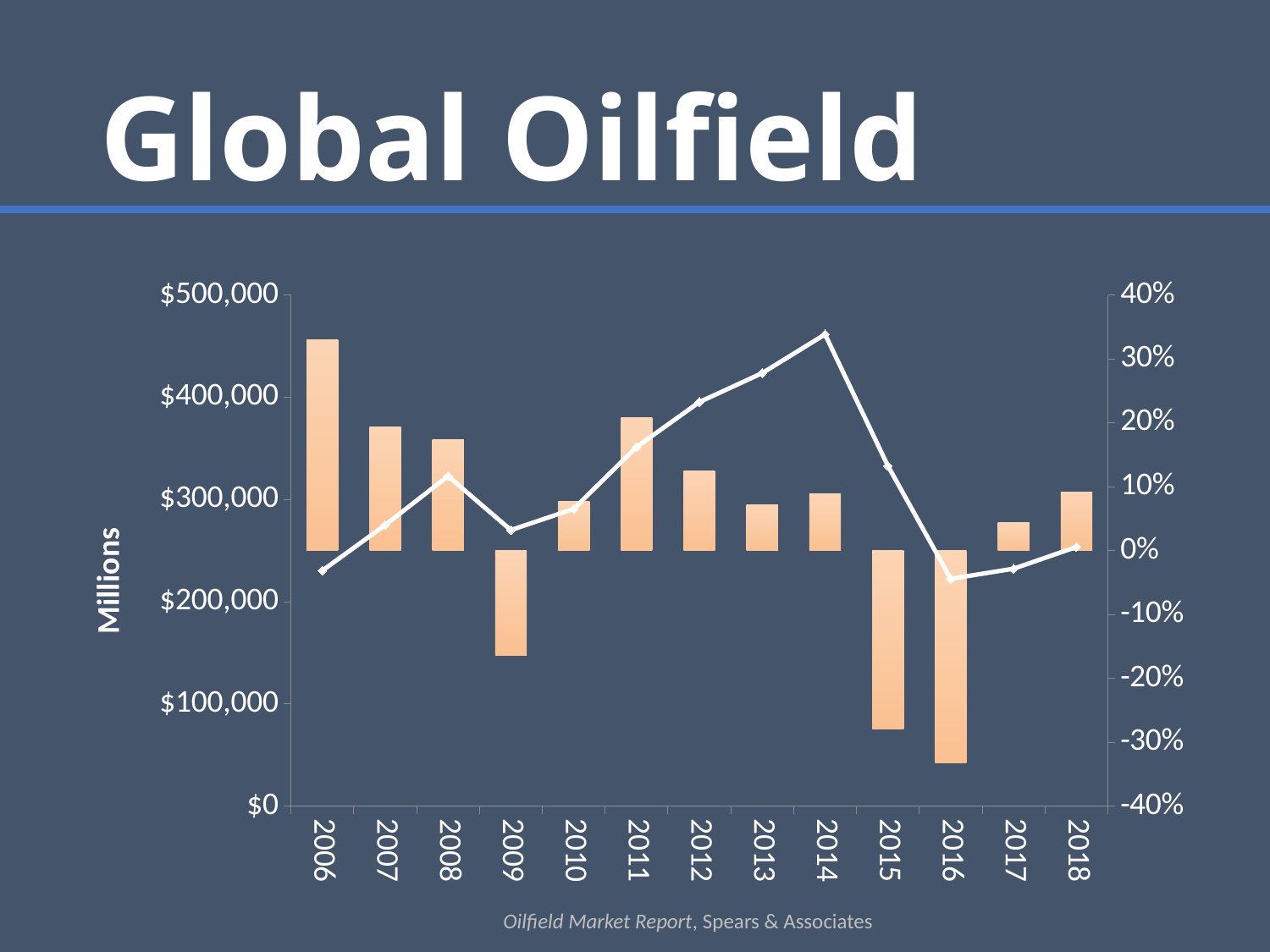
How many years are shown along the x axis of the chart? 13 Which year has the tallest bar above the baseline? 2006 Does the top of the 2006 bar lie above or below the $400,000 gridline on the left axis? above Does the 2014 point on the white line lie above or below the 30% mark on the right axis? above How many bars extend below the baseline? 3 Does the white line rise or fall between 2009 and 2014? rise Which year's bar extends furthest below the baseline? 2016 What is the label on the left vertical axis of the chart? Millions Which bar is taller, 2011 or 2012? 2011 In which year does the white line reach its highest point? 2014 What kind of chart is shown on the slide? A combination bar and line chart Does the bottom of the 2016 bar lie above or below the $100,000 mark on the left axis? below